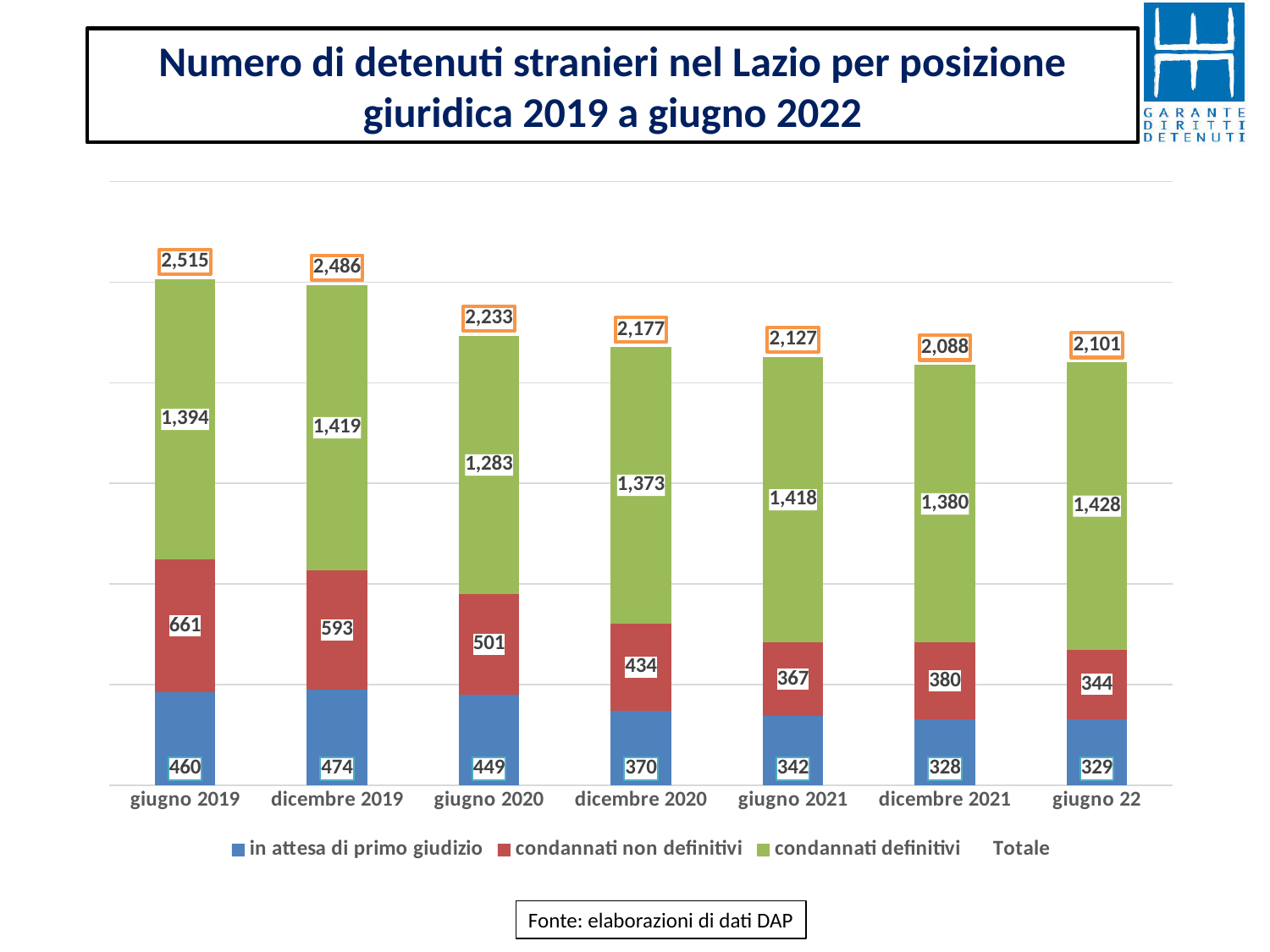
What is the value for 'condannati non definitivi' in giugno 22? 344 What is the value for 'in attesa di primo giudizio' in dicembre 2020? 370 Which is larger: 'condannati non definitivi' in giugno 2020 or in dicembre 2020? giugno 2020 How many periods are shown on the x axis? 7 What is the value for 'condannati definitivi' in giugno 2019? 1,394 Which period has the highest Totale? giugno 2019 What is the difference between the Totale for giugno 2019 and the Totale for giugno 22? 414 What is the Totale shown for dicembre 2021? 2,088 Which period has the lowest value for 'in attesa di primo giudizio'? dicembre 2021 Does the value for 'condannati non definitivi' rise or fall from giugno 2019 to giugno 2021? fall What kind of chart is shown on the slide? stacked bar chart How many series does the legend list? 4